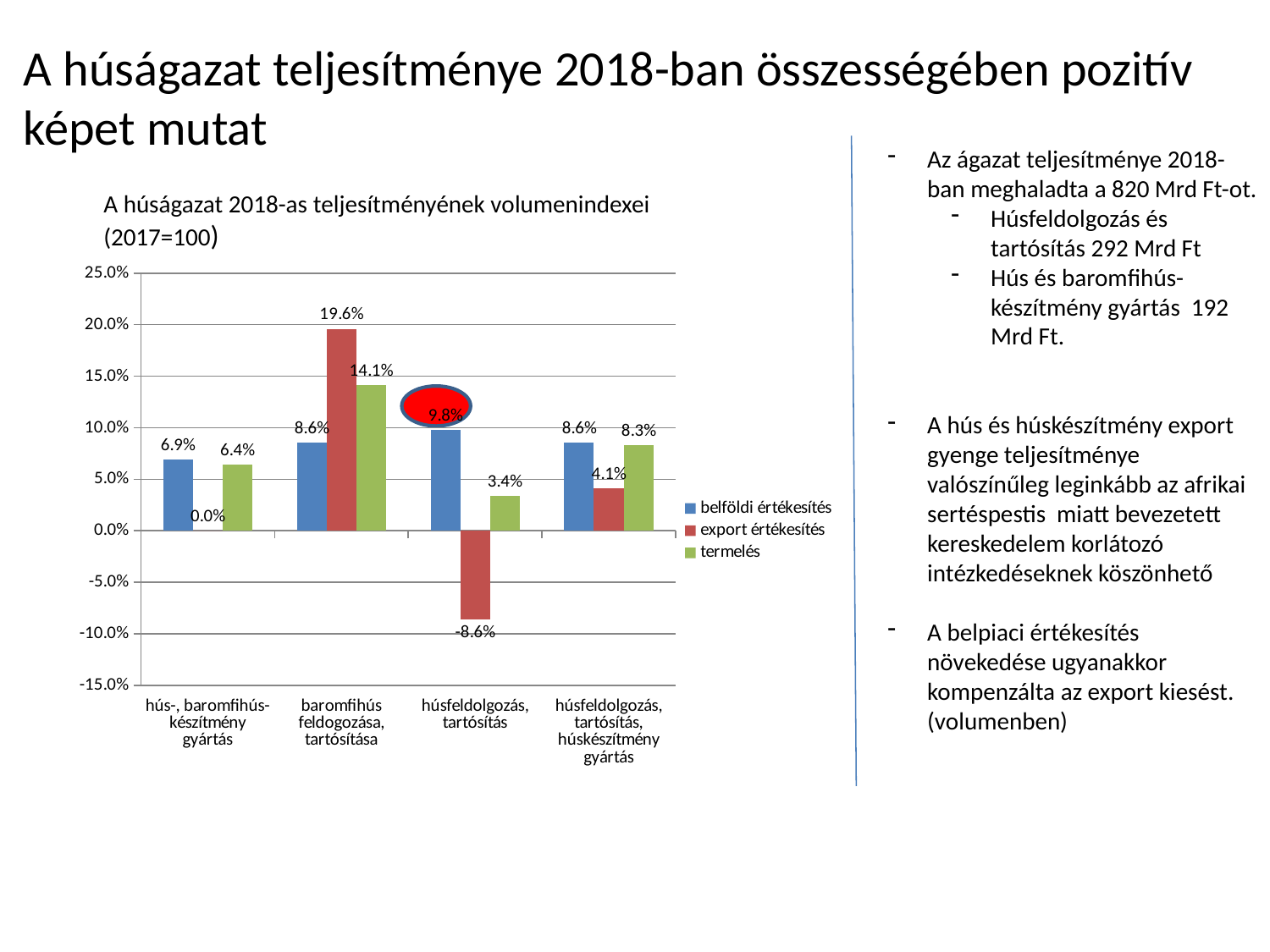
How many series does the chart legend list? 3 What is the export értékesítés value for húsfeldolgozás, tartósítás? -8.6% What is the difference between the export értékesítés and termelés values for baromfihús feldogozása, tartósítása? 5.5% What is the title of the chart? A húságazat 2018-as teljesítményének volumenindexei (2017=100) Which category has the lowest termelés value? húsfeldolgozás, tartósítás Which category has the highest export értékesítés value? baromfihús feldogozása, tartósítása What is the export értékesítés value for baromfihús feldogozása, tartósítása? 19.6% What is the belföldi értékesítés value for hús-, baromfihús-készítmény gyártás? 6.9% What type of chart is shown on the slide? bar chart Which is larger for húsfeldolgozás, tartósítás: belföldi értékesítés or termelés? belföldi értékesítés How many categories are shown on the x axis of the chart? 4 What is the termelés value for húsfeldolgozás, tartósítás, húskészítmény gyártás? 8.3%